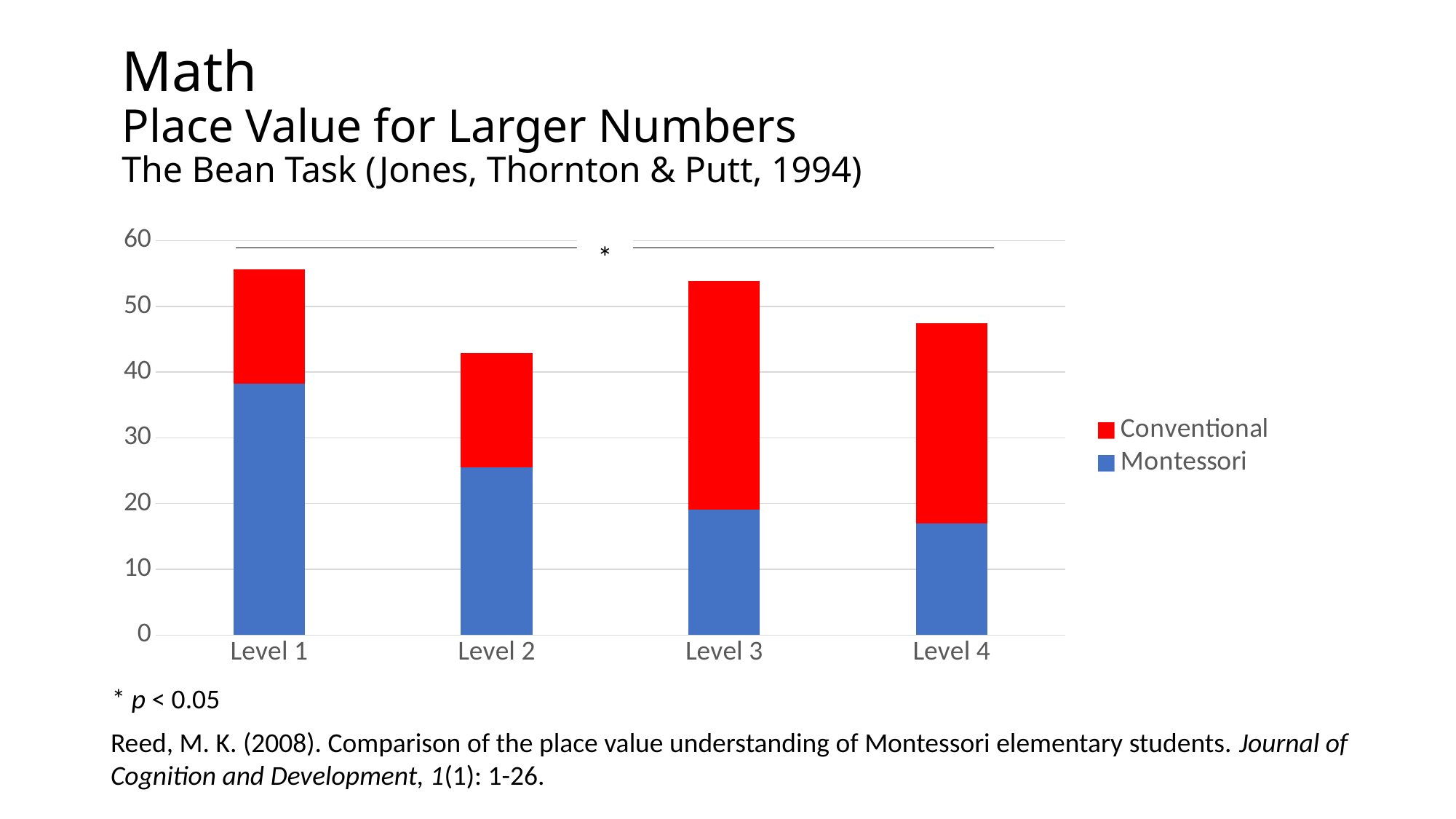
Which colour represents the Conventional series? Red Which level has the highest Conventional value? Level 3 How many levels (categories) are shown on the x axis? 4 Do the Montessori values rise or fall from Level 1 to Level 4? fall Which level has the lowest total stacked bar? Level 2 Is the Montessori value for Level 1 greater or less than 30? greater What kind of chart is shown on the slide? Stacked bar chart Is the Montessori value for Level 4 greater or less than 20? less Is the total stacked bar for Level 3 greater or less than 50? greater How many series does the legend list? 2 Which level has the highest Montessori value? Level 1 Which is larger, the Montessori value for Level 1 or the Montessori value for Level 3? Level 1